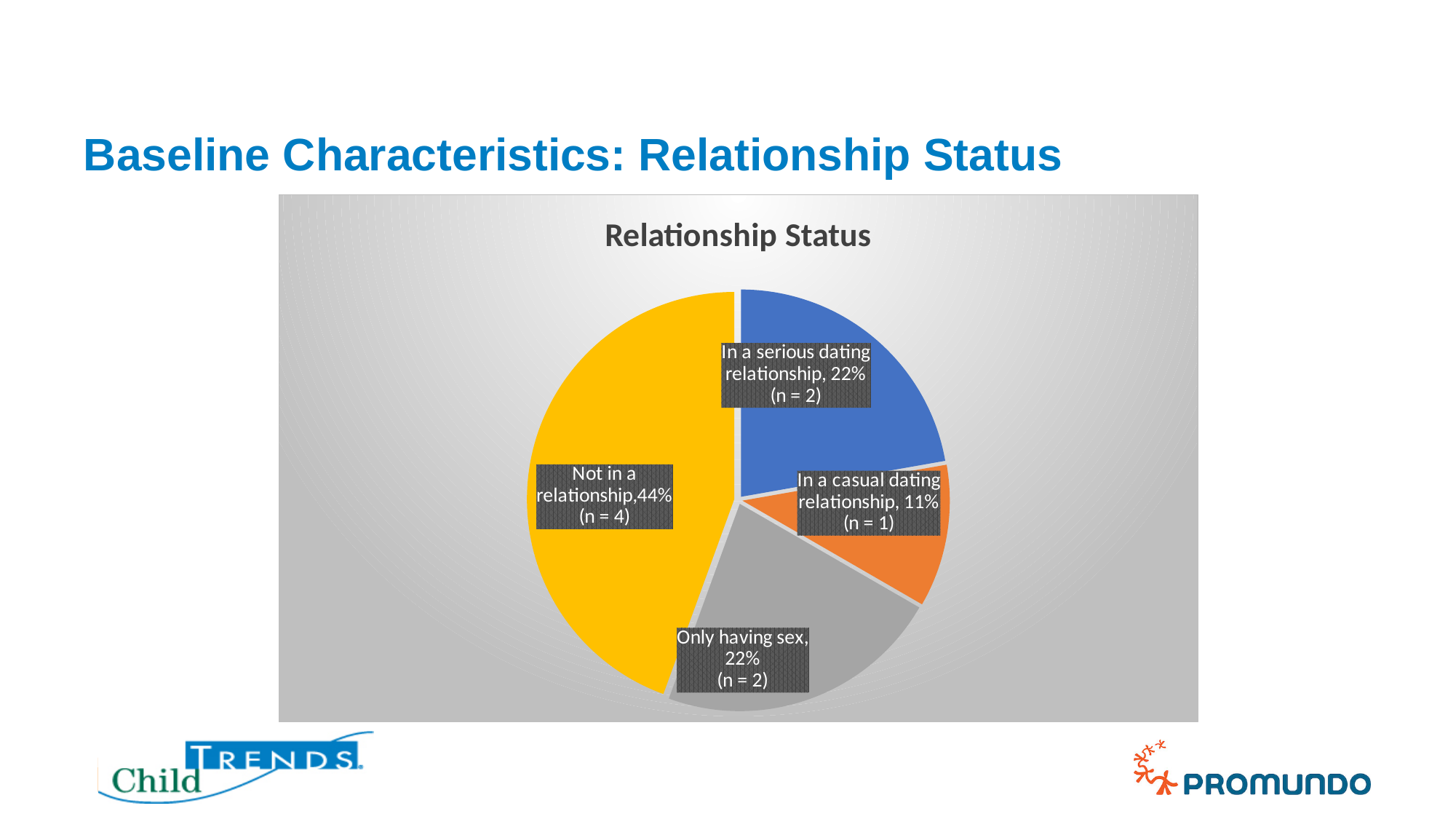
What percentage of the pie is 'In a casual dating relationship'? 11% What is the n value shown for 'Not in a relationship'? n = 4 What kind of chart is shown on the slide? pie chart What percentage of the pie is 'In a serious dating relationship'? 22% How many slices does the pie chart have? 4 Which category has the largest slice of the pie? Not in a relationship What percentage of the pie is 'Not in a relationship'? 44% Which category has the smallest slice of the pie? In a casual dating relationship Which colour is the 'Not in a relationship' slice? yellow What is the difference in percentage points between 'Not in a relationship' and 'In a casual dating relationship'? 33 What is the n value shown for 'Only having sex'? n = 2 What is the title of the chart? Relationship Status